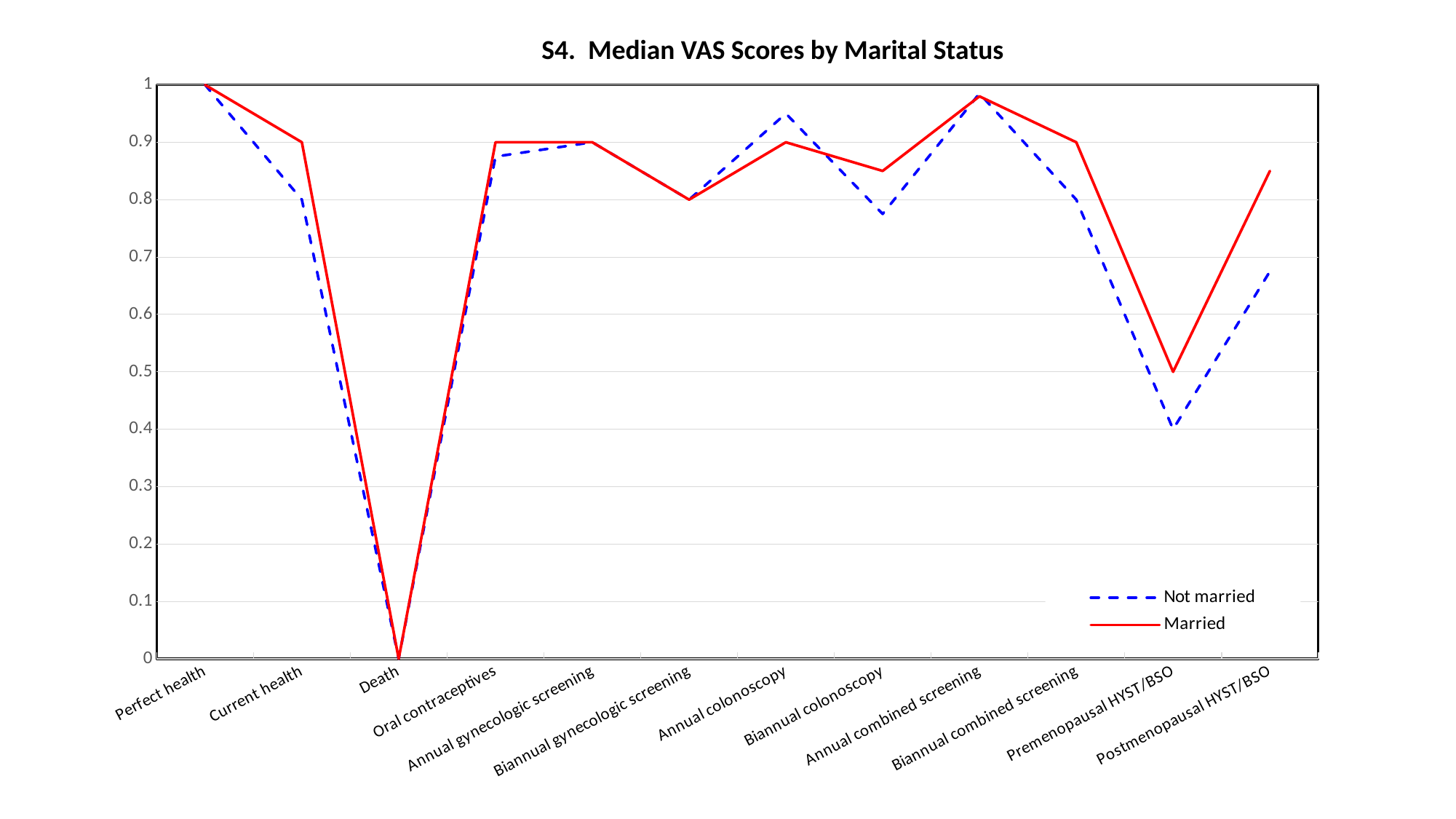
How many series does the legend list? 2 What kind of chart is shown on the slide? Line chart Is the Not married value for Postmenopausal HYST/BSO greater or less than 0.7? less For Premenopausal HYST/BSO, which series has the larger median VAS score, Married or Not married? Married For Annual colonoscopy, which series has the larger median VAS score, Married or Not married? Not married How many categories are shown along the x axis? 12 Which category has the highest median VAS score for the Married series? Perfect health Which series is drawn with a dashed blue line? Not married Is the Married value for Postmenopausal HYST/BSO greater or less than 0.8? greater What is the median VAS score for Death for the Married series? 0 Which category has the lowest median VAS score for the Not married series? Death What is the Married median VAS score for Premenopausal HYST/BSO? 0.5